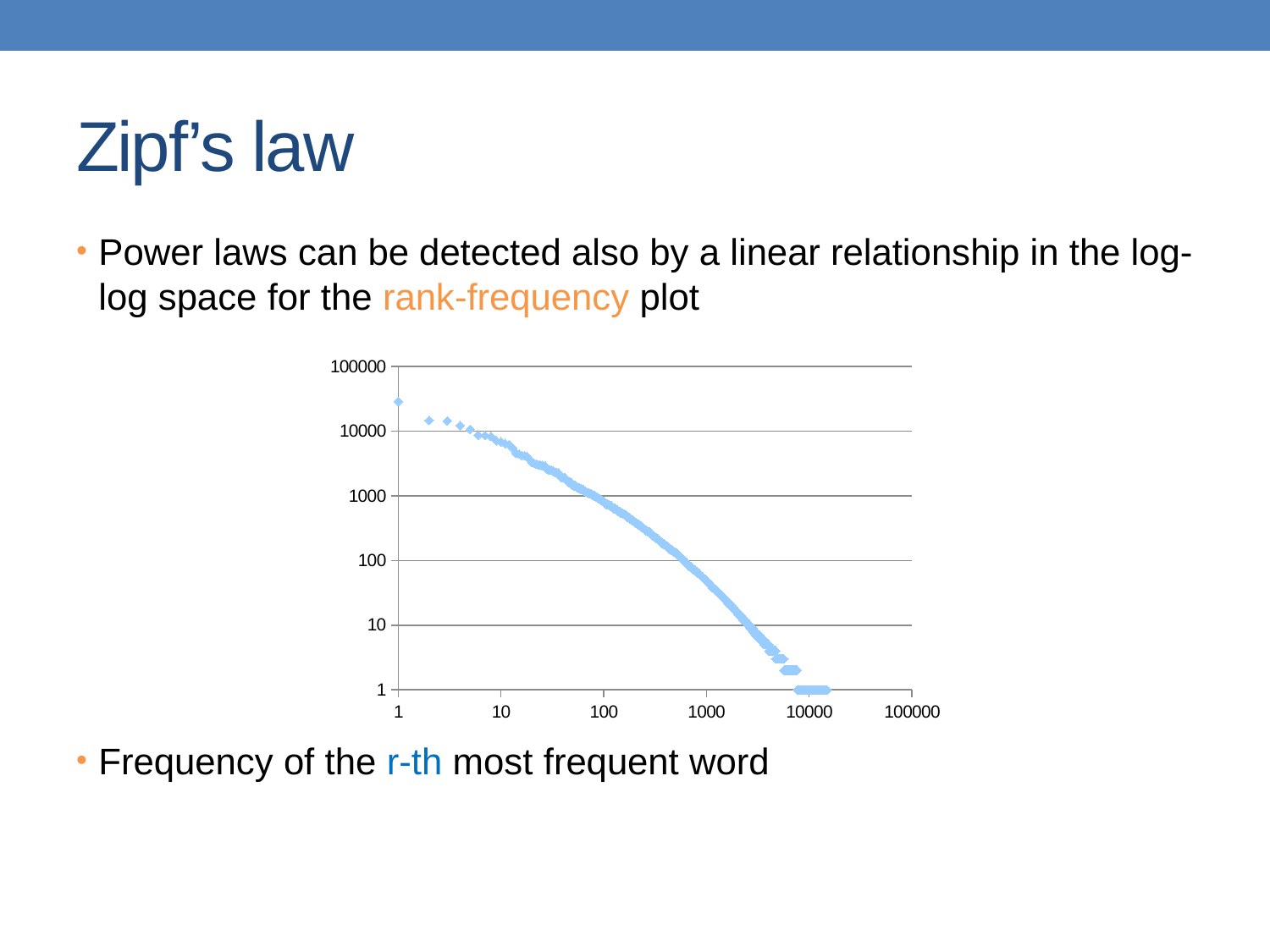
Are the axes of the chart on a linear or a logarithmic scale? logarithmic Is the frequency at rank 10000 greater or less than 10? less What is the lowest frequency value that the plotted points reach? 1 What kind of chart is shown on the slide? scatter plot What is the highest tick label on the y axis? 100000 Do the plotted frequencies rise or fall as the rank increases along the x axis? fall Is the frequency at rank 1000 greater or less than 100? less Is the frequency of the rank-1 word greater or less than 10000? greater